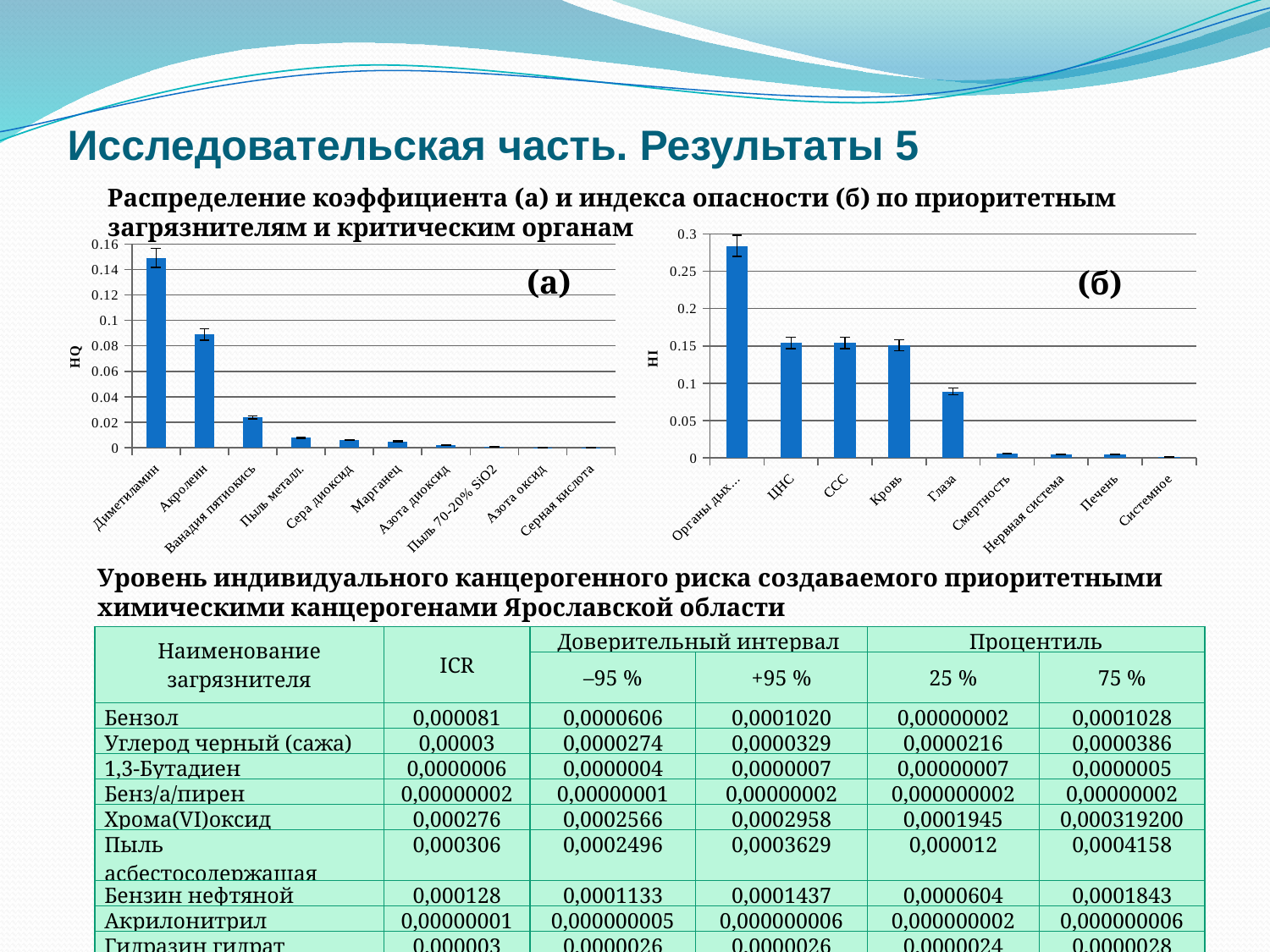
In chart (а), is the value for Акролеин greater or less than 0.1? less In chart (а), is the value for Диметиламин greater or less than 0.14? greater How many categories are shown on the x axis of chart (б)? 9 What type of chart is chart (б)? bar chart In chart (а), is the value for Ванадия пятиокись greater or less than 0.04? less In chart (а), which category has the highest HQ value? Диметиламин How many categories are shown on the x axis of chart (а)? 10 In chart (б), which category has the highest HI value? Органы дых... In chart (а), which is larger, the value for Акролеин or the value for Пыль металл.? Акролеин In chart (б), which is larger, the value for Кровь or the value for Глаза? Кровь